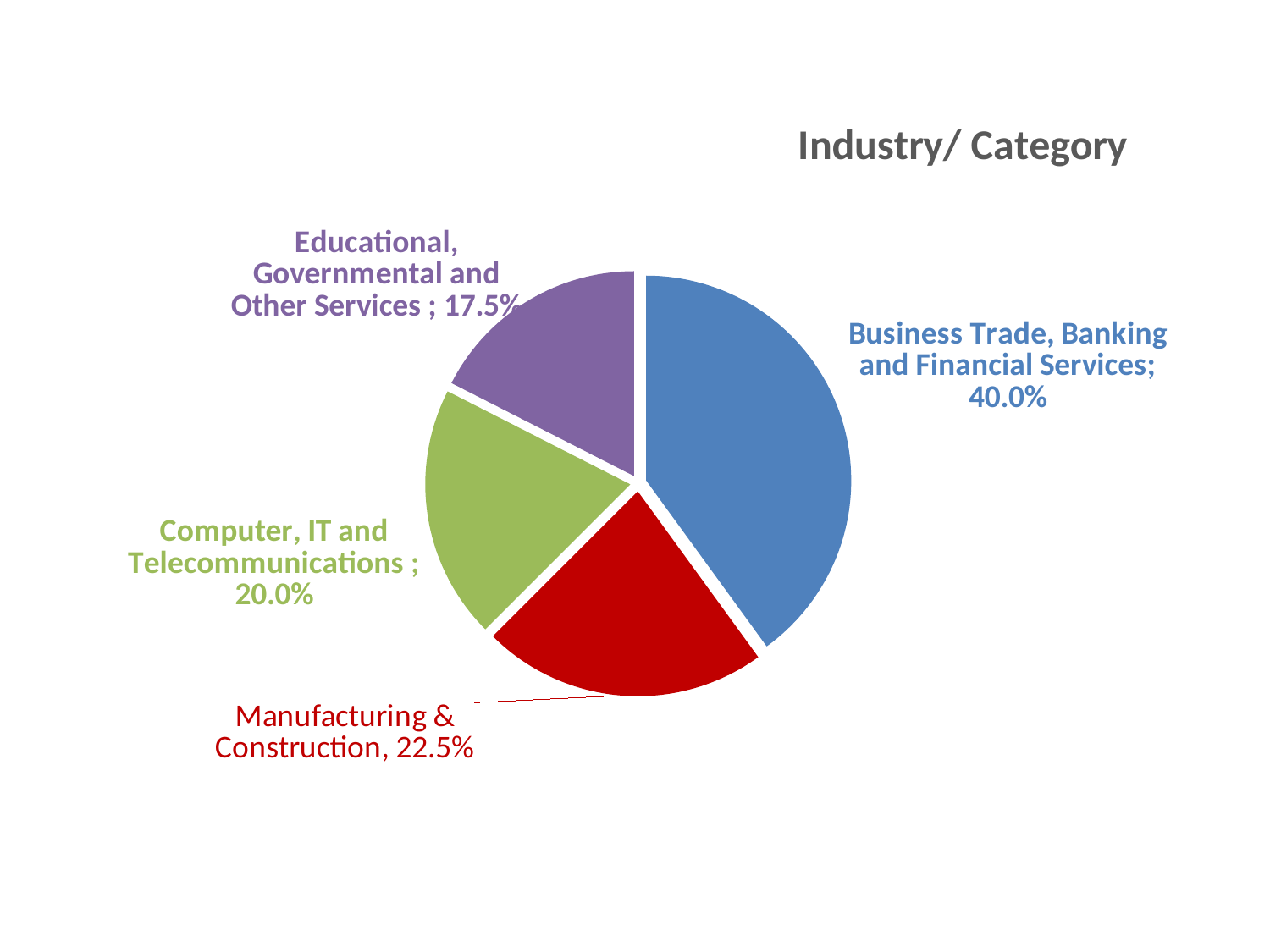
What is the title of the chart? Industry/ Category What type of chart is shown on the slide? pie chart What share does Educational, Governmental and Other Services have? 17.5% How many categories are shown in the pie chart? 4 What is the difference between the shares of Business Trade, Banking and Financial Services and Manufacturing & Construction? 17.5% Which category has the smallest slice? Educational, Governmental and Other Services Which is larger: Computer, IT and Telecommunications or Educational, Governmental and Other Services? Computer, IT and Telecommunications What share does Business Trade, Banking and Financial Services have? 40.0% What colour is the Manufacturing & Construction slice? red Which category has the largest slice? Business Trade, Banking and Financial Services What share does Manufacturing & Construction have? 22.5% What share does Computer, IT and Telecommunications have? 20.0%